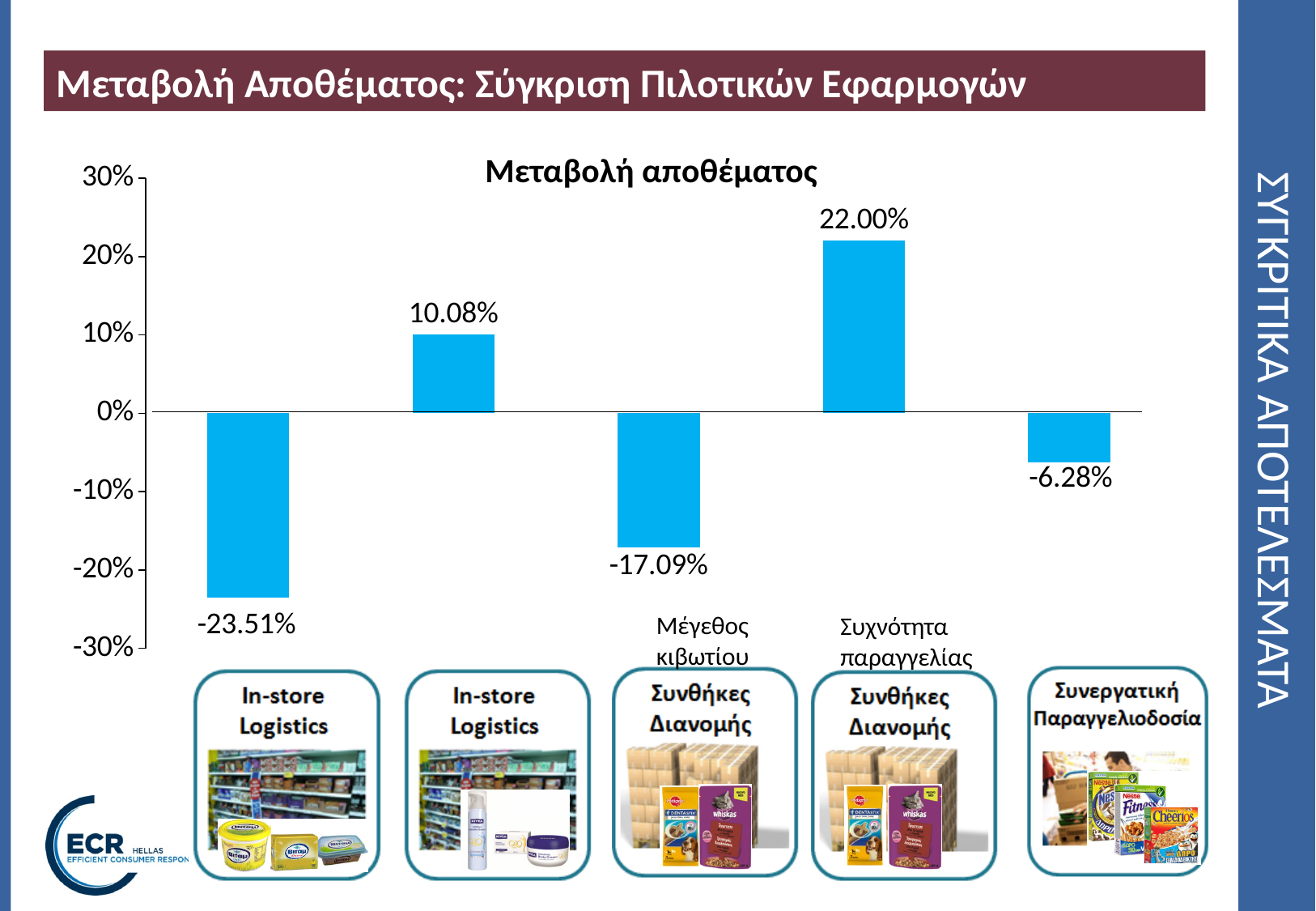
What is the difference between the value for Συχνότητα παραγγελίας (22.00%) and the second In-store Logistics bar (10.08%)? 11.92 percentage points What type of chart is shown on the slide? bar chart Which is larger: the value for Μέγεθος κιβωτίου or the value for Συνεργατική Παραγγελιοδοσία? Συνεργατική Παραγγελιοδοσία Which bar has the lowest value in the chart? the first In-store Logistics bar (-23.51%) What is the title of the chart? Μεταβολή αποθέματος What is the value of the first (leftmost) bar, for the first In-store Logistics pilot? -23.51% What is the value for Συνθήκες Διανομής – Μέγεθος κιβωτίου? -17.09% Which pilot has the highest value in the chart? Συνθήκες Διανομής – Συχνότητα παραγγελίας What is the value for Συνεργατική Παραγγελιοδοσία? -6.28% What is the value of the second bar, for the second In-store Logistics pilot? 10.08% What is the value for Συνθήκες Διανομής – Συχνότητα παραγγελίας? 22.00% How many bars are plotted in the chart? 5